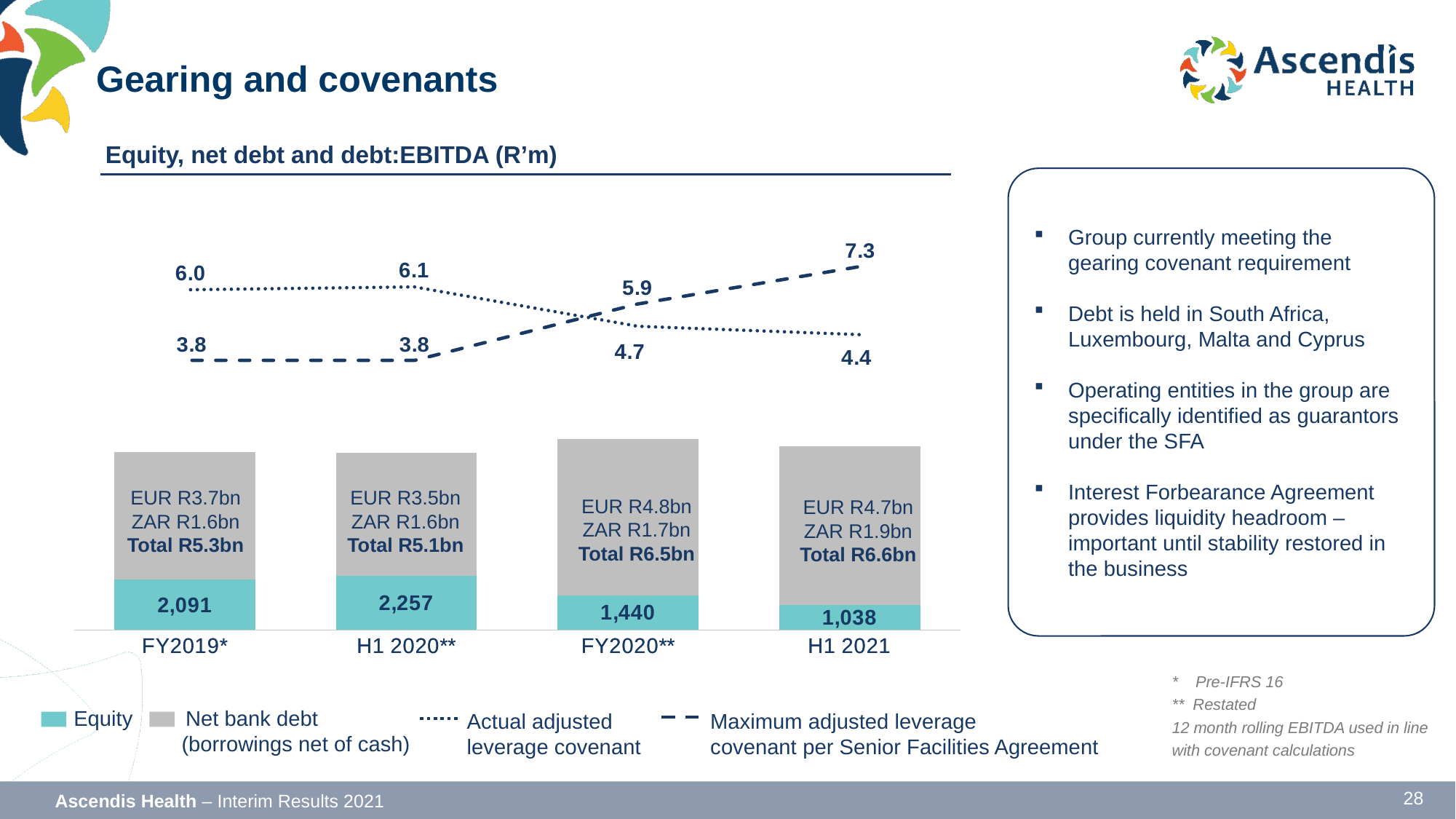
What is the total net bank debt shown for FY2019*? R5.3bn Which period has the lowest Equity value? H1 2021 What is the EUR portion of net bank debt for FY2020**? EUR R4.8bn What is the Equity value for H1 2021? 1,038 For FY2020**, which is larger: the Maximum adjusted leverage covenant or the Actual adjusted leverage covenant? Maximum adjusted leverage covenant What is the difference between the Equity value for FY2019* and for H1 2021? 1,053 How many series does the chart legend list? 4 What is the Actual adjusted leverage covenant value for FY2020**? 4.7 How many periods are shown on the x axis of the chart? 4 What is the Maximum adjusted leverage covenant per Senior Facilities Agreement for H1 2021? 7.3 Does the Maximum adjusted leverage covenant rise or fall from FY2019* to H1 2021? Rise Which period has the highest Equity value? H1 2020**